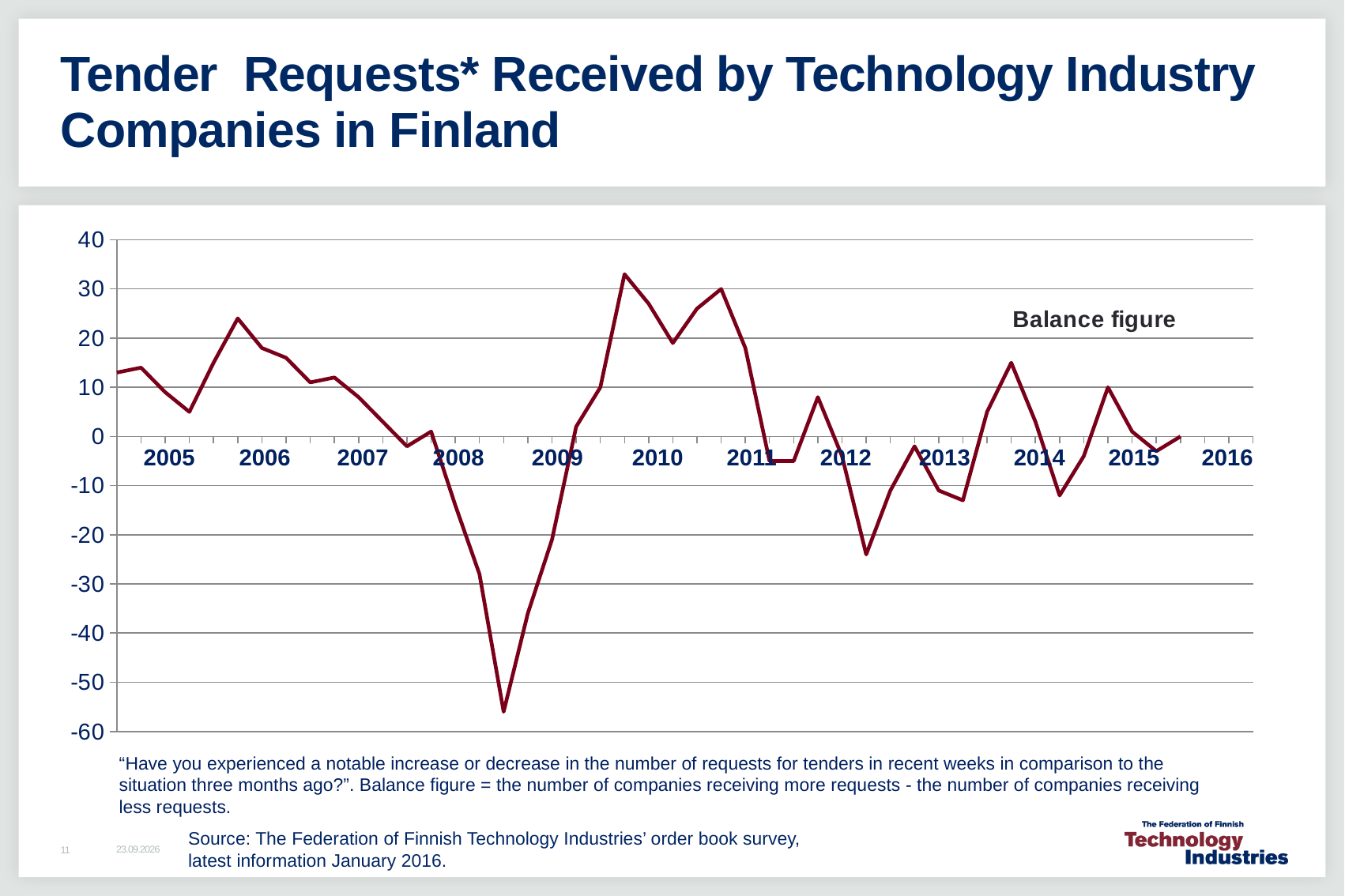
Is the lowest value reached around 2012 greater or less than -20? less Is the lowest value reached by the line greater or less than -50? less Is the peak value reached during 2006 greater or less than 20? greater What is the label shown for the plotted series? Balance figure Does the line rise or fall between its deepest trough in 2008 and its peak around 2009-2010? rise Does the line rise or fall from its peak in 2010 to 2011? fall What kind of chart is shown on the slide? line chart How many year labels are shown on the x axis? 12 What colour is the plotted line? dark red